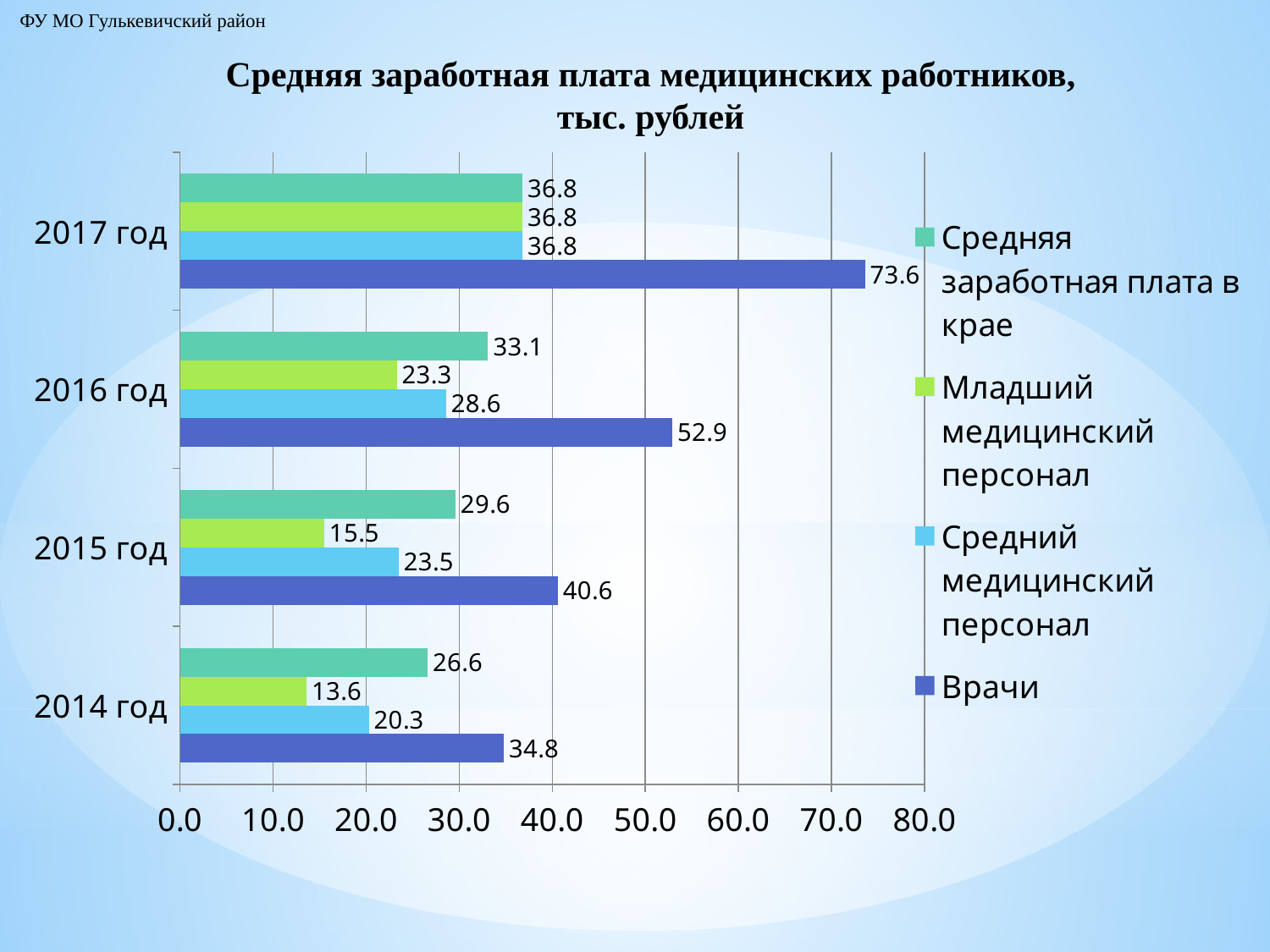
Which is larger in 2016 год: Средний медицинский персонал or Младший медицинский персонал? Средний медицинский персонал What is the value for Младший медицинский персонал in 2015 год? 15.5 What is the value for Средний медицинский персонал in 2014 год? 20.3 In which year is the value for Врачи the highest? 2017 год How many years are shown on the chart? 4 In which year is the value for Младший медицинский персонал the lowest? 2014 год What is the value for Средняя заработная плата в крае in 2016 год? 33.1 What kind of chart is this? bar chart What is the value for Врачи in 2017 год? 73.6 What is the difference between the Врачи value in 2017 год and in 2016 год? 20.7 Does the value for Врачи rise or fall from 2014 год to 2017 год? rise How many series does the legend list? 4